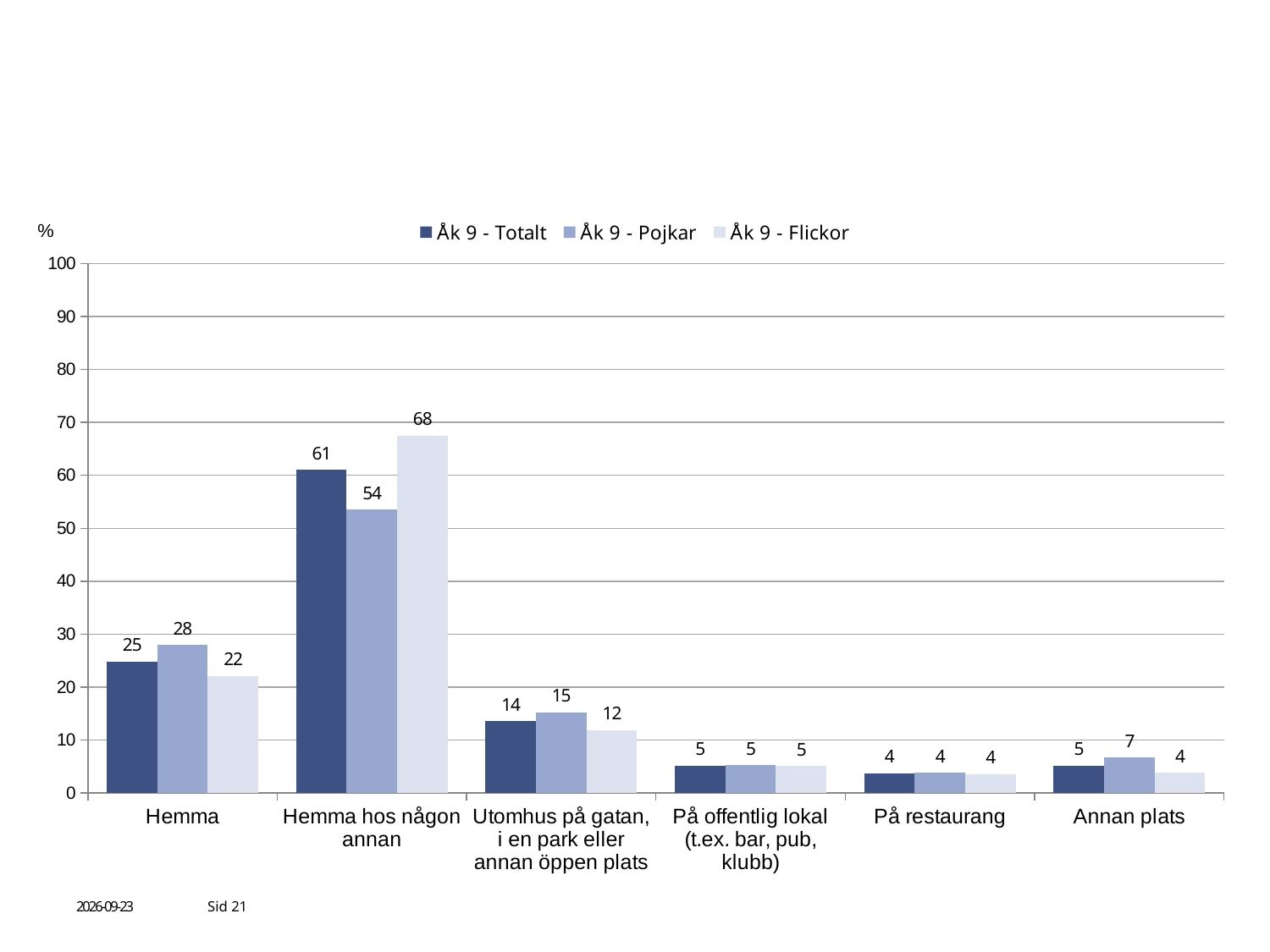
Which category has the highest value for Åk 9 - Totalt? Hemma hos någon annan What is the value for Åk 9 - Pojkar in the category "Hemma"? 28 Which category has the lowest value for Åk 9 - Pojkar? På restaurang What is the value for Åk 9 - Flickor in the category "Hemma hos någon annan"? 68 How many series does the legend list? 3 What is the value for Åk 9 - Totalt in the category "Utomhus på gatan, i en park eller annan öppen plats"? 14 How many categories are shown on the x axis? 6 What unit is indicated on the y axis of the chart? % What is the difference between the Åk 9 - Flickor and Åk 9 - Pojkar values in the category "Hemma hos någon annan"? 14 In the category "Hemma", which series has the larger value, Åk 9 - Pojkar or Åk 9 - Flickor? Åk 9 - Pojkar What kind of chart is shown on the slide? bar chart Is the value for Åk 9 - Totalt in "Hemma hos någon annan" greater or less than 50? greater